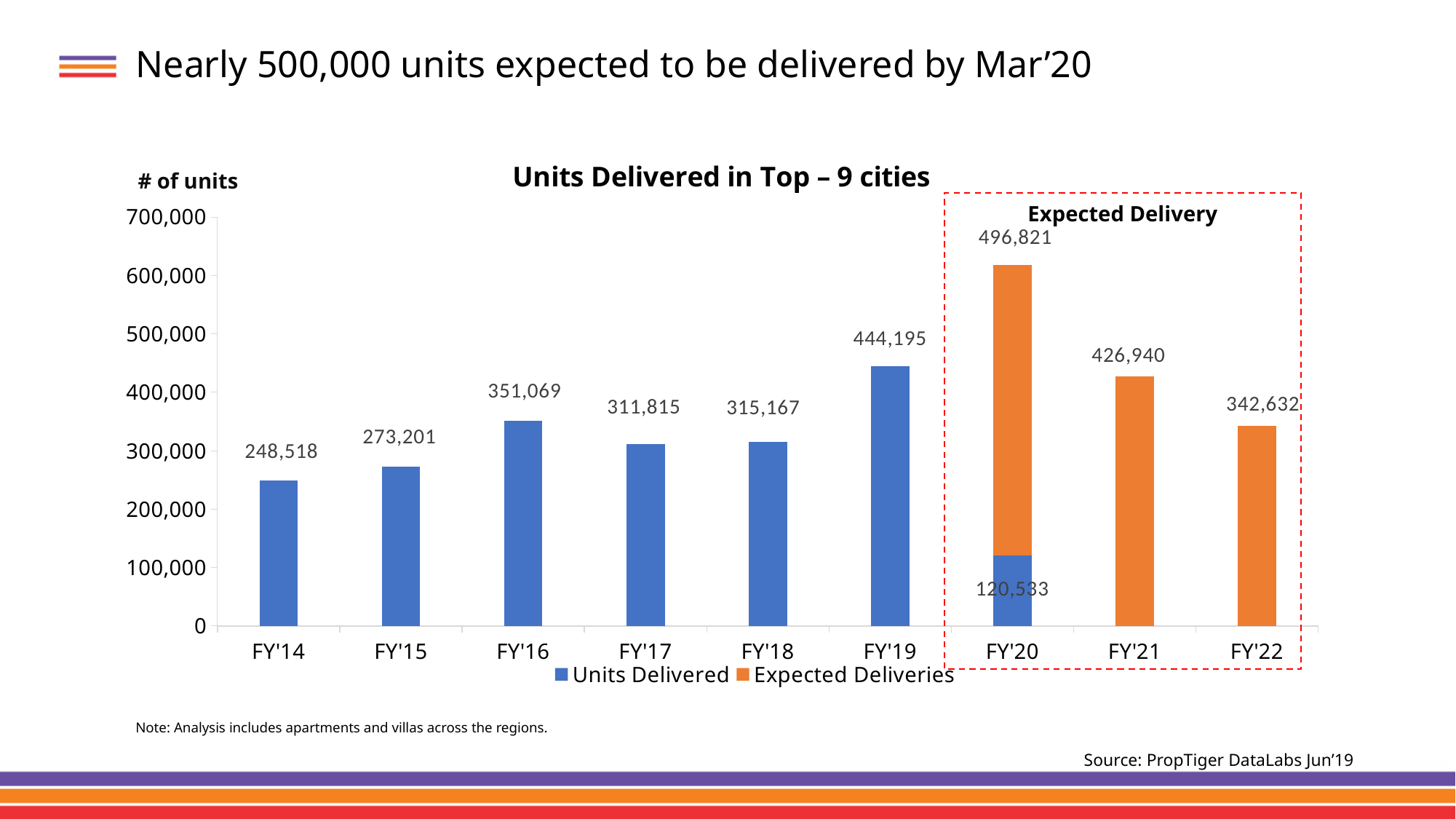
Which fiscal year has the lowest value for Expected Deliveries? FY'22 How many fiscal years are shown on the x axis? 9 What is the value for Units Delivered in FY'20? 120,533 What is the value for Expected Deliveries in FY'21? 426,940 How many series does the legend list? 2 What is the difference between Units Delivered in FY'19 and FY'18? 129,028 Which fiscal year has the highest value for Units Delivered? FY'19 What is the value for Units Delivered in FY'14? 248,518 Which is larger, Units Delivered in FY'16 or in FY'17? FY'16 What is the title of the chart? Units Delivered in Top – 9 cities What kind of chart is shown on the slide? Bar chart What is the value for Units Delivered in FY'19? 444,195